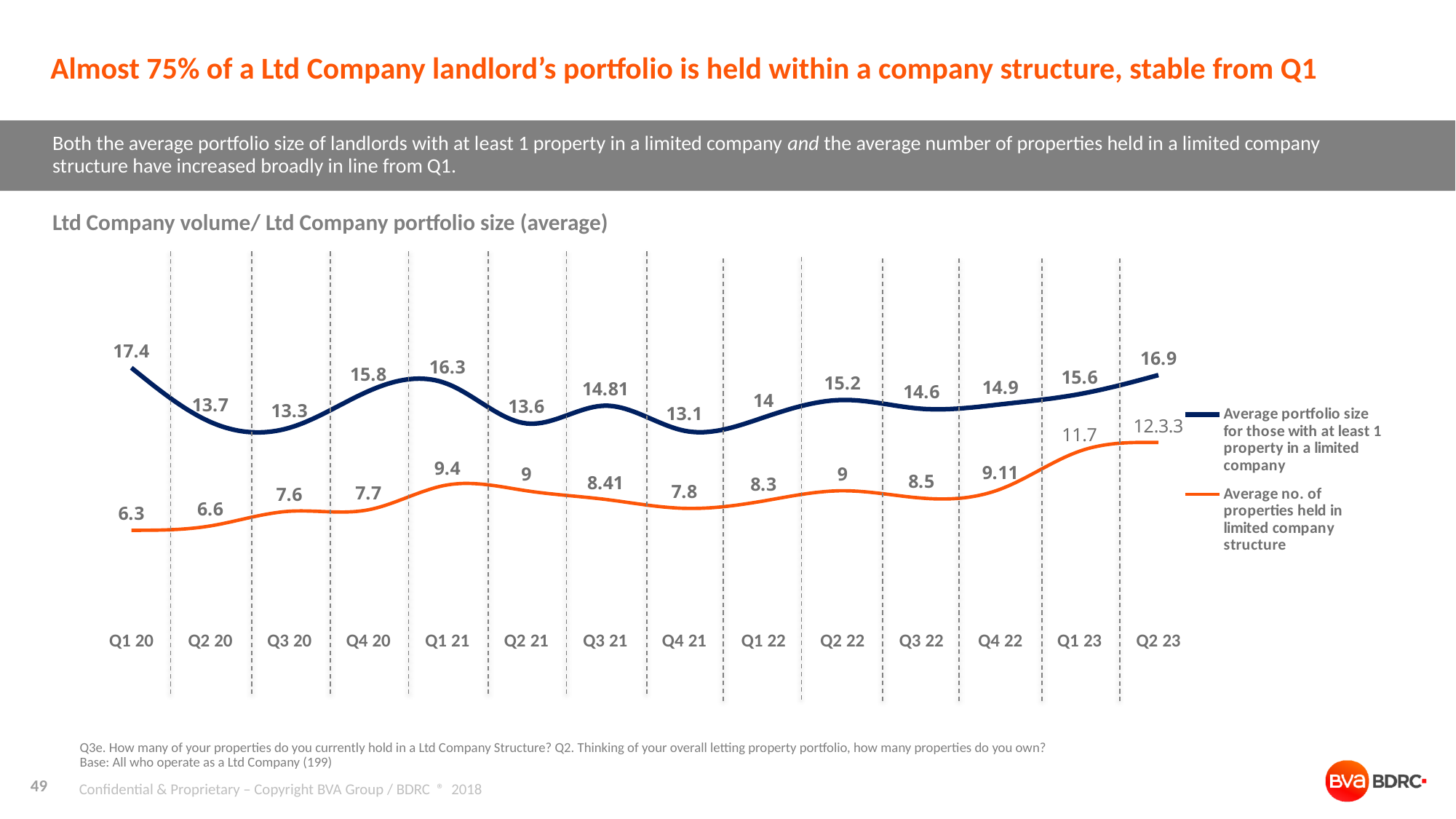
What type of chart is shown on the slide? Line chart Does the average number of properties held in limited company structure rise or fall from Q1 20 to Q1 21? Rise What is the title of the chart? Ltd Company volume/ Ltd Company portfolio size (average) What is the average portfolio size for those with at least 1 property in a limited company in Q1 20? 17.4 In which quarter is the average portfolio size for those with at least 1 property in a limited company highest? Q1 20 What is the average portfolio size for those with at least 1 property in a limited company in Q3 21? 14.81 Which is larger: the average number of properties held in limited company structure in Q1 21 or in Q4 21? Q1 21 In which quarter is the average number of properties held in limited company structure lowest? Q1 20 What is the average number of properties held in limited company structure in Q1 23? 11.7 How many quarters are plotted along the x axis? 14 How many series does the legend list? 2